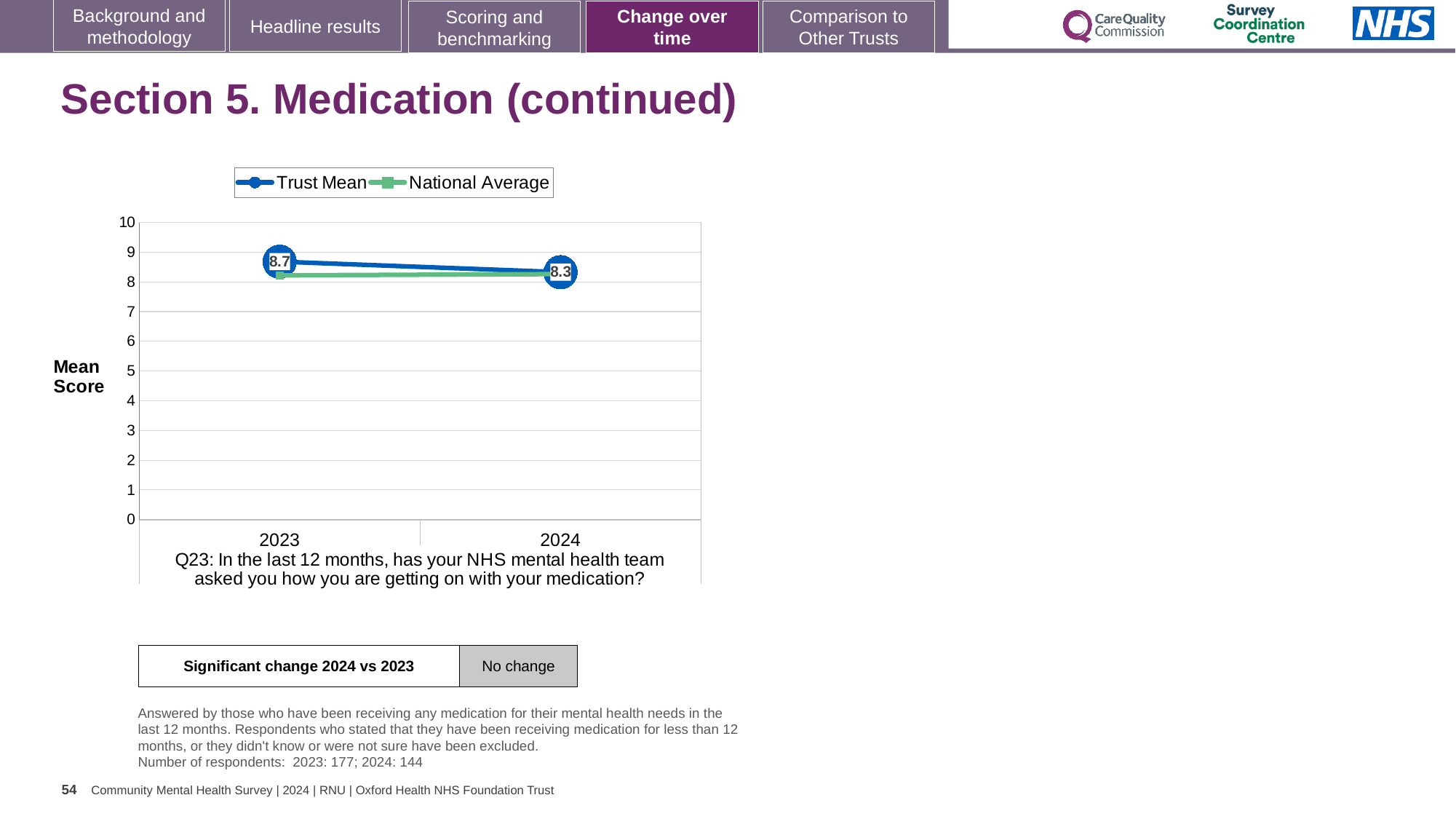
What is the difference between the Trust Mean in 2023 and in 2024? 0.4 In which year is the Trust Mean highest? 2023 What is the Trust Mean value for 2024? 8.3 Which is larger, the Trust Mean for 2023 or for 2024? 2023 Is the National Average value for 2024 greater or less than 5? greater What kind of chart is shown on the slide? line chart Does the Trust Mean rise or fall from 2023 to 2024? fall In which year is the Trust Mean lowest? 2024 What is the label on the y axis of the chart? Mean Score What is the Trust Mean value for 2023? 8.7 How many years are shown on the x axis of the chart? 2 How many series does the chart legend list? 2